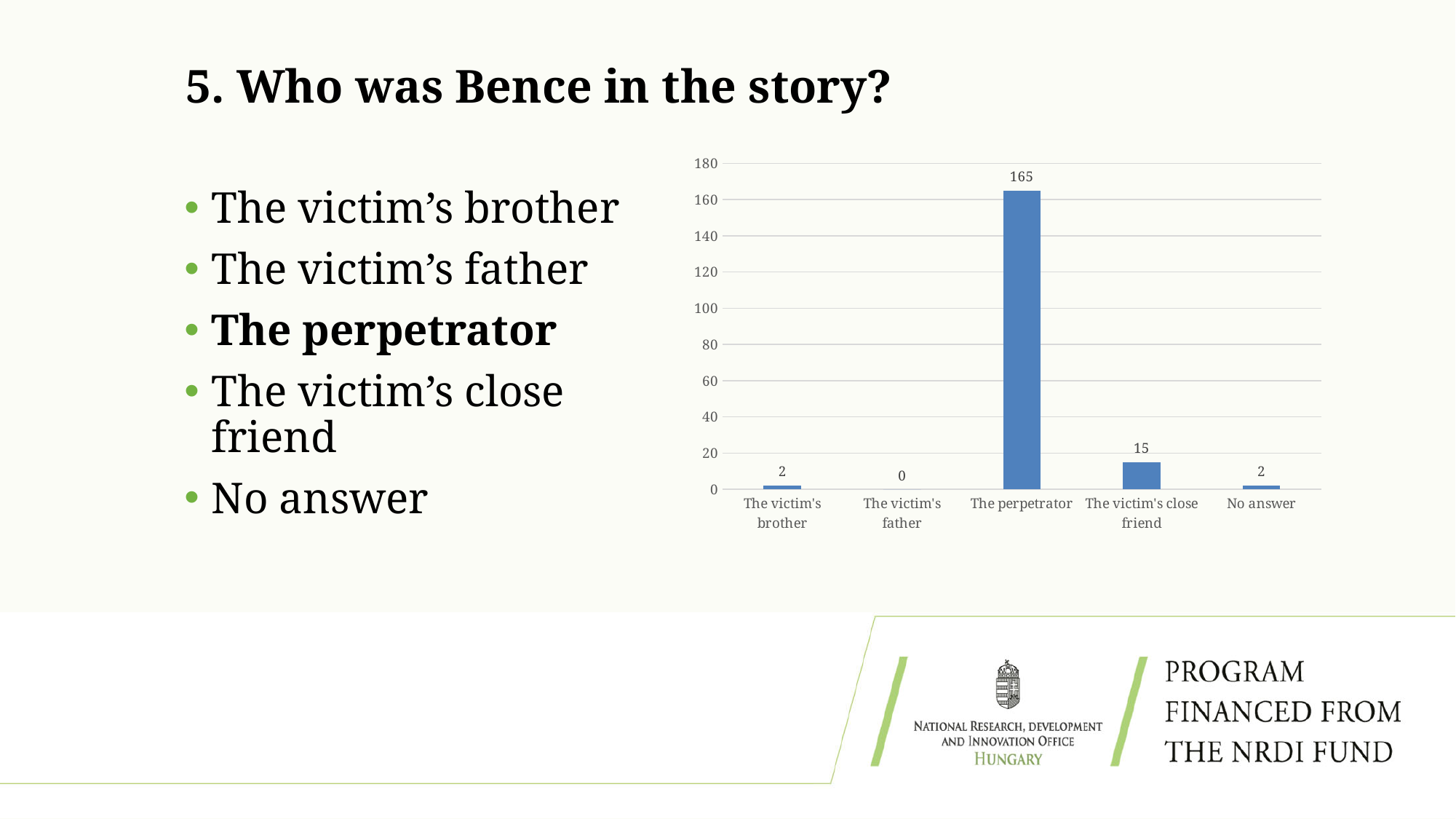
Which category has the lowest value? The victim's father Which is larger, the value for The victim's close friend or the value for The victim's brother? The victim's close friend What is the difference between the values for The perpetrator and The victim's close friend? 150 Is the value for The perpetrator greater or less than 160? greater What is the value for The perpetrator? 165 How many categories are shown on the x axis? 5 What is the value for The victim's close friend? 15 Which category has the highest value? The perpetrator What is the value for No answer? 2 What kind of chart is shown on the slide? Bar chart What is the value for The victim's father? 0 What is the highest value shown on the y axis? 180